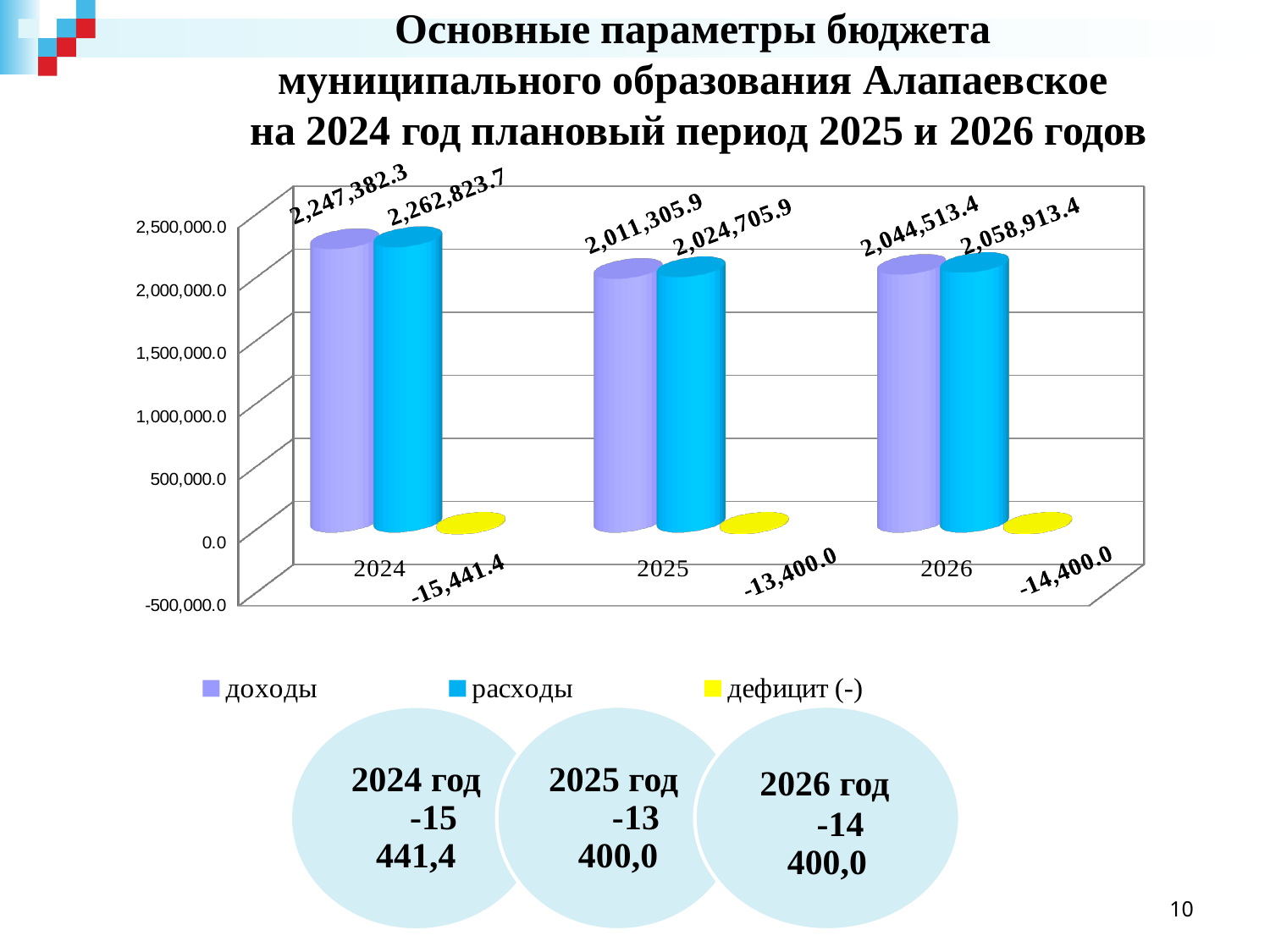
What is the difference between расходы and доходы in 2024? 15,441.4 What is the value of доходы for 2024? 2,247,382.3 Which is larger in 2025, доходы or расходы? расходы Do доходы rise or fall from 2024 to 2025? fall In which year are расходы lowest? 2025 What is the value of расходы for 2025? 2,024,705.9 What is the value of дефицит (-) for 2026? -14,400.0 What kind of chart is shown on the slide? bar chart In which year are доходы highest? 2024 How many years are shown on the x axis? 3 What is the difference between расходы and доходы in 2026? 14,400.0 How many series does the legend list? 3